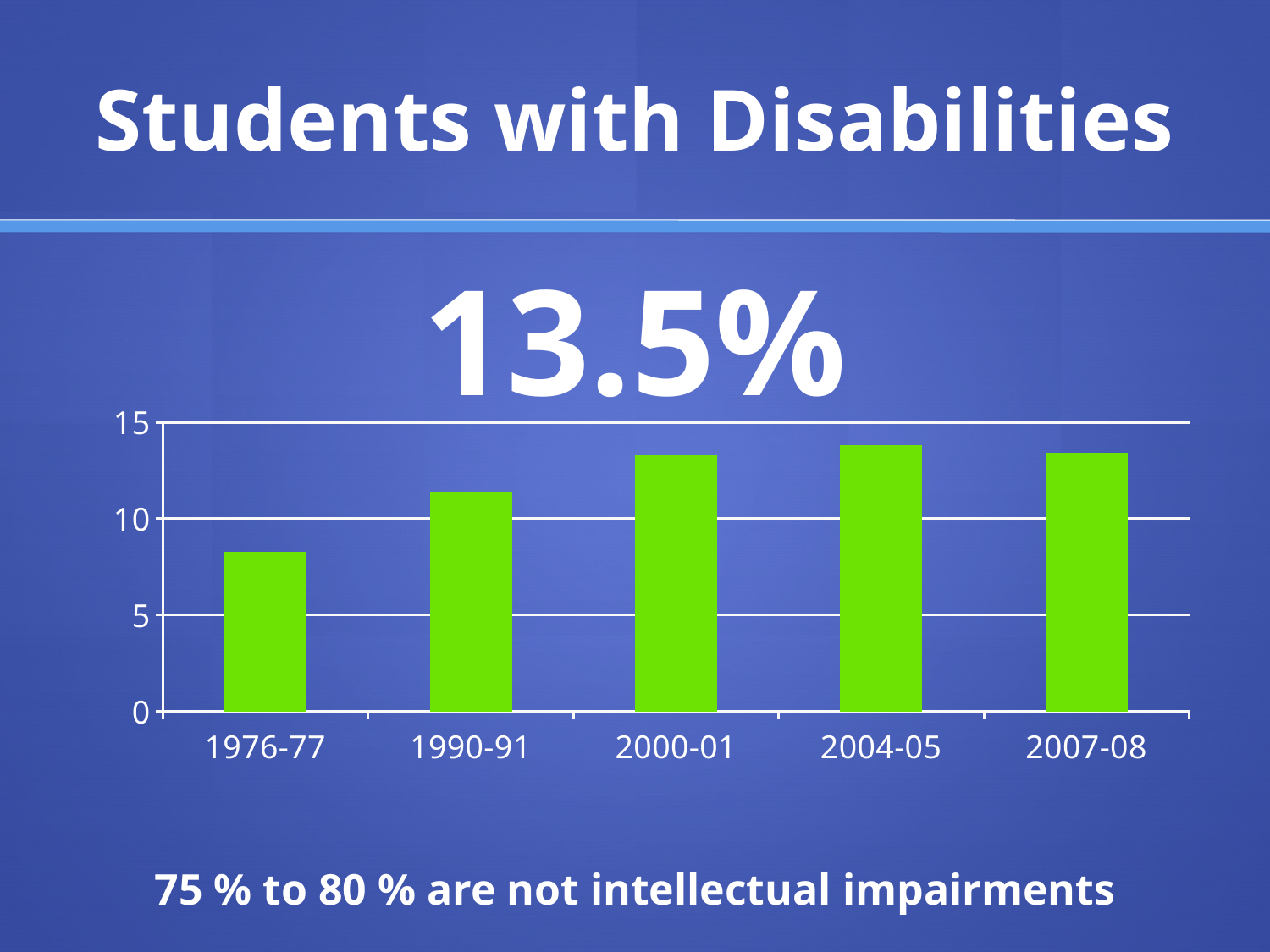
Is the value for 1990-91 greater or less than 10? greater Which school year has the highest bar in the chart? 2004-05 What colour are the bars in the chart? green Do the values rise or fall from 1976-77 to 2000-01? rise What is the title of the slide containing the chart? Students with Disabilities Is the value for 1976-77 greater or less than 10? less Is the value for 2004-05 greater or less than 15? less Which school year has the lowest bar in the chart? 1976-77 What kind of chart is shown on the slide? bar chart Which is larger, the value for 1976-77 or the value for 1990-91? 1990-91 How many school years are shown on the x axis of the chart? 5